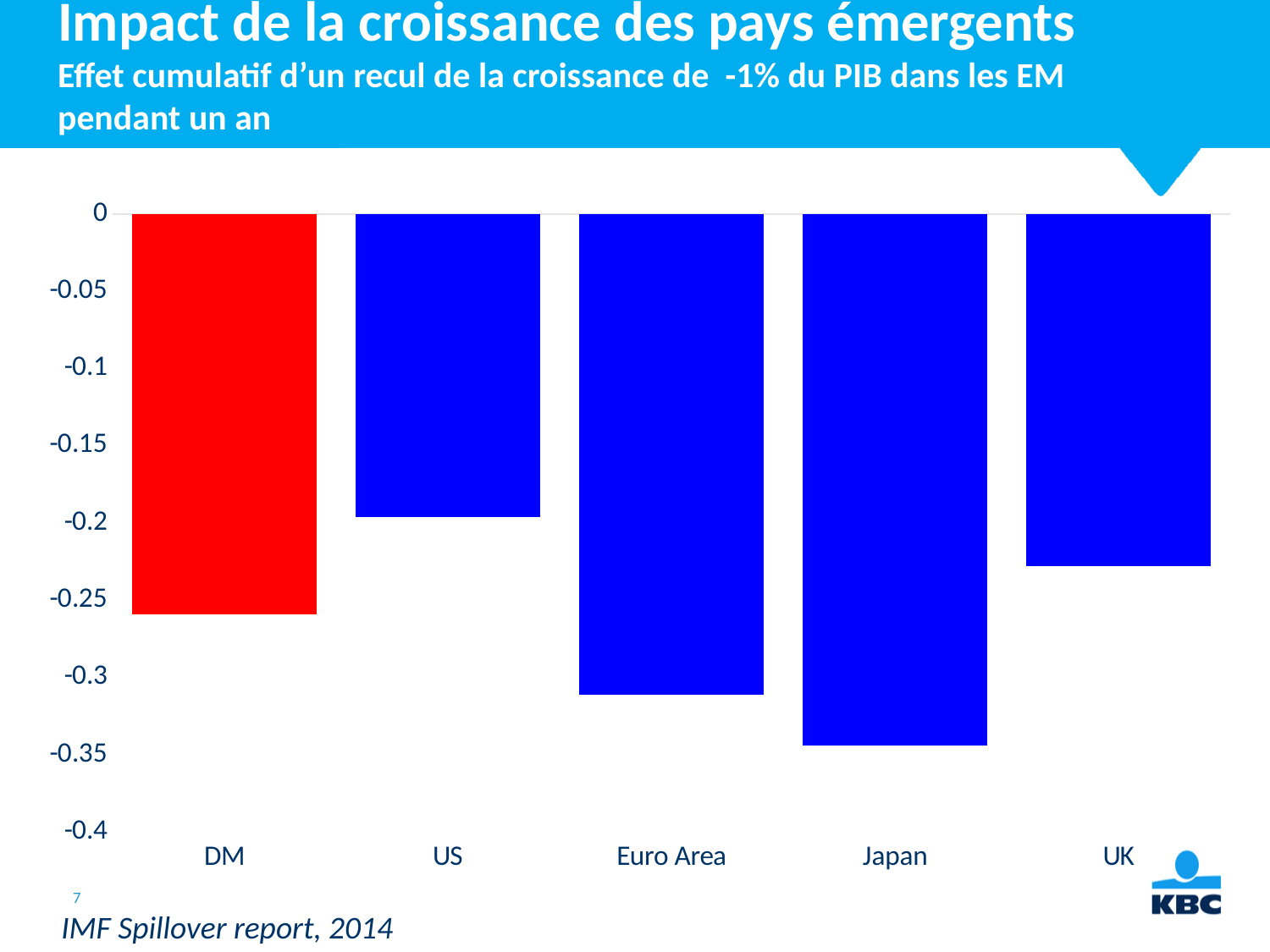
What kind of chart is shown on the slide? Bar chart How many categories are shown on the x axis of the chart? 5 Is the value for UK greater or less than -0.25? greater Which category has the highest value (closest to zero) in the chart? US Is the value for Euro Area greater or less than -0.3? less What source is cited below the chart? IMF Spillover report, 2014 Is the value for UK greater or less than -0.2? less Which bar is shown in red rather than blue? DM Which has the more negative value, Japan or Euro Area? Japan Which category has the lowest (most negative) value in the chart? Japan